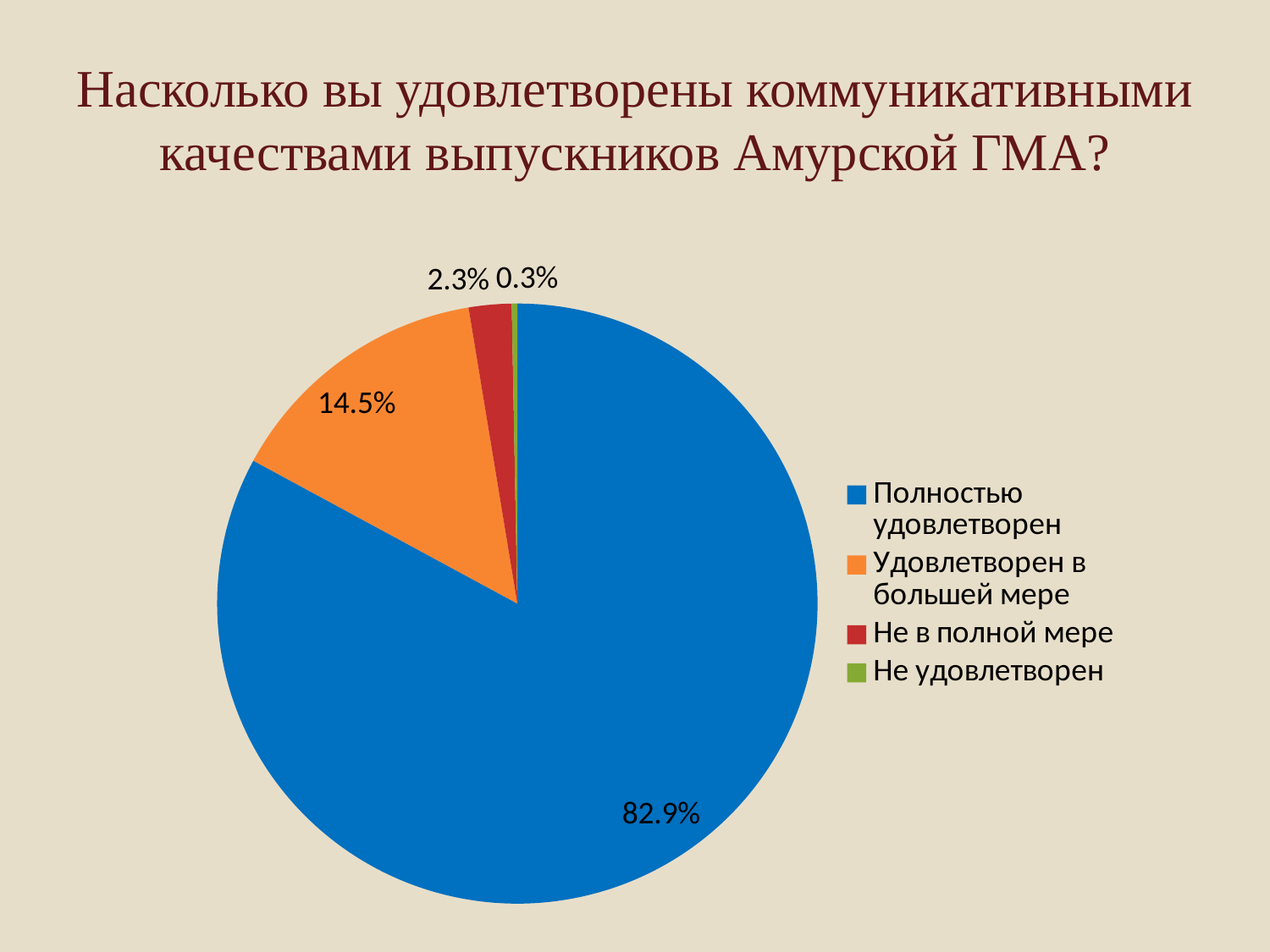
What share of respondents answered "Не в полной мере"? 2.3% How many categories does the pie chart have? 4 What is the title of the slide containing the chart? Насколько вы удовлетворены коммуникативными качествами выпускников Амурской ГМА? What colour is the slice for "Удовлетворен в большей мере"? Orange What share of respondents answered "Удовлетворен в большей мере"? 14.5% What share of respondents answered "Полностью удовлетворен"? 82.9% Which category has the smallest slice of the pie? Не удовлетворен Which is larger: the share for "Не в полной мере" or the share for "Не удовлетворен"? Не в полной мере What share of respondents answered "Не удовлетворен"? 0.3% What kind of chart is shown on the slide? Pie chart What is the difference between the shares for "Полностью удовлетворен" and "Удовлетворен в большей мере"? 68.4% Which category has the largest slice of the pie? Полностью удовлетворен